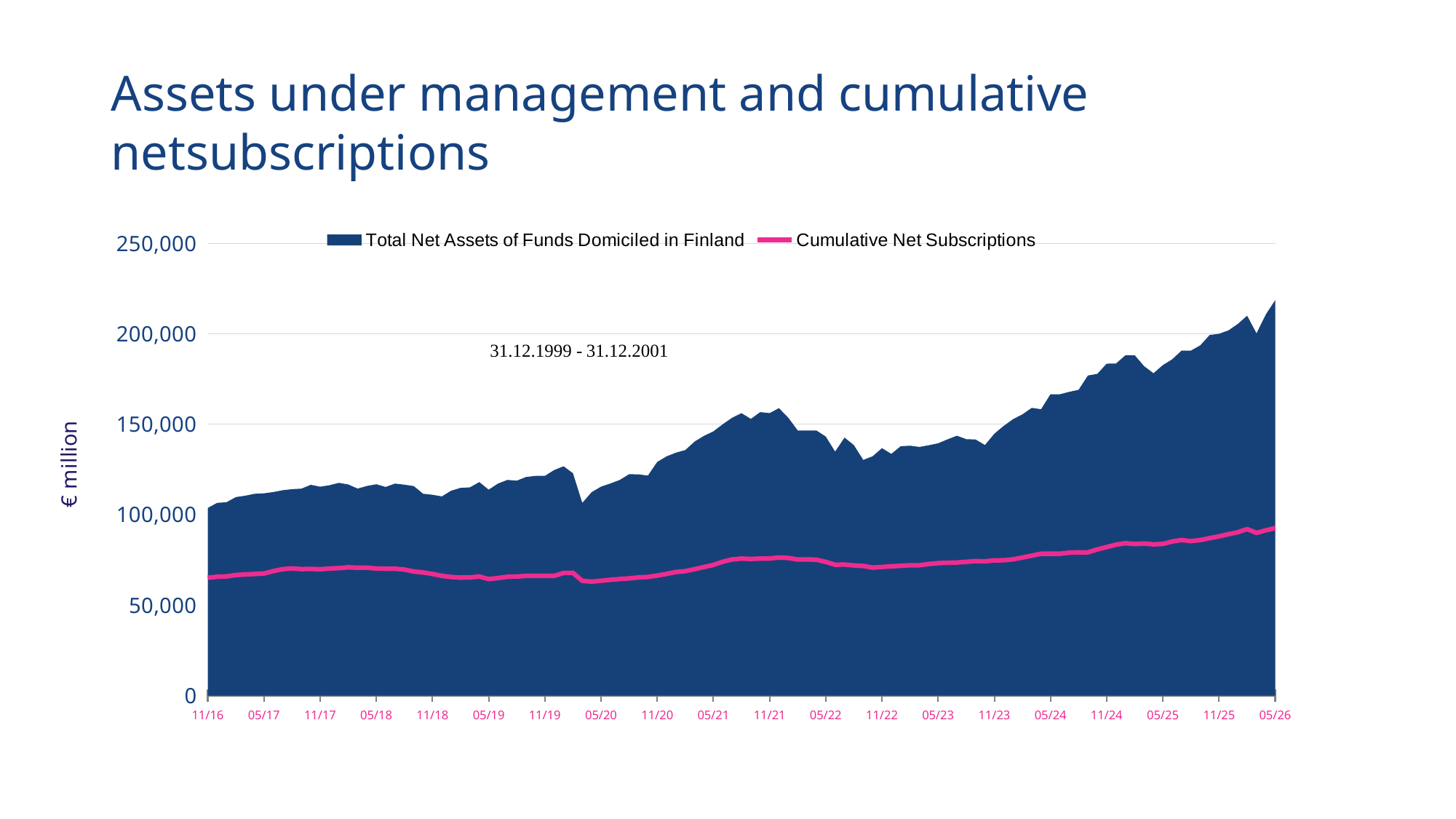
How many date labels are shown on the x axis? 20 What kind of chart is used to show Total Net Assets of Funds Domiciled in Finland? Area chart At 05/26, which is larger: Total Net Assets of Funds Domiciled in Finland or Cumulative Net Subscriptions? Total Net Assets of Funds Domiciled in Finland Overall, do Total Net Assets of Funds Domiciled in Finland rise or fall from 11/16 to 05/26? rise What date range is written in the annotation inside the chart area? 31.12.1999 - 31.12.2001 At which x-axis date do Total Net Assets of Funds Domiciled in Finland reach their highest value? 05/26 Is the value of Cumulative Net Subscriptions at 11/16 greater or less than 50,000? greater What unit is shown on the y-axis label? € million Is the value of Total Net Assets of Funds Domiciled in Finland at 05/26 greater or less than 200,000? greater Is the value of Cumulative Net Subscriptions at 05/26 greater or less than 100,000? less How many series does the chart legend list? 2